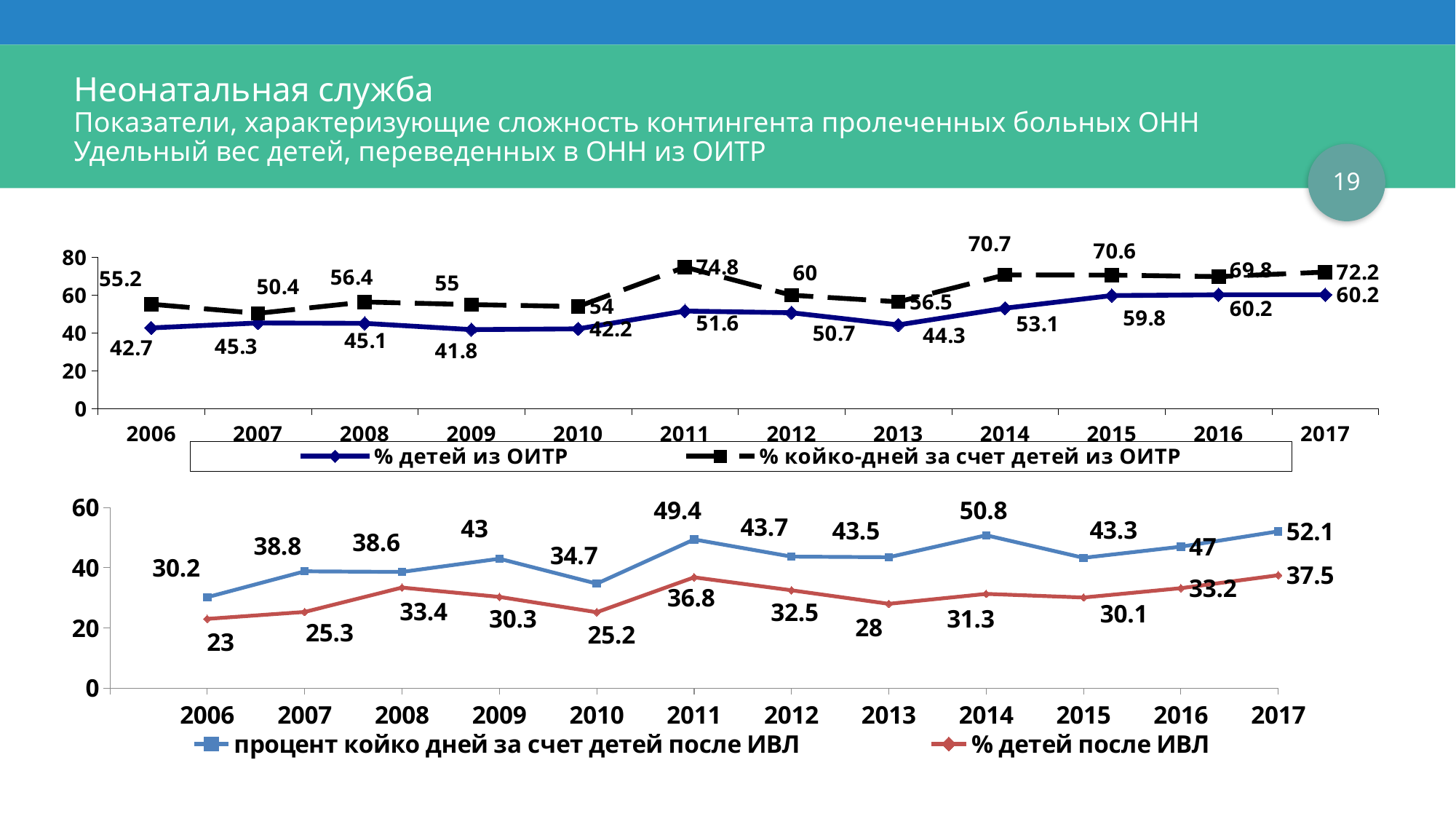
How many years are shown on the x axis of the bottom chart? 12 In the top chart, what is the value of "% детей из ОИТР" for 2011? 51.6 In the top chart, what is the value of "% койко-дней за счет детей из ОИТР" for 2014? 70.7 In the top chart, what is the difference between "% койко-дней за счет детей из ОИТР" and "% детей из ОИТР" in 2017? 12 In the bottom chart, in which year is "% детей после ИВЛ" lowest? 2006 What type of chart is the bottom chart? line chart In the bottom chart, which is larger in 2014: "процент койко дней за счет детей после ИВЛ" or "% детей после ИВЛ"? процент койко дней за счет детей после ИВЛ In the bottom chart, what is the value of "% детей после ИВЛ" for 2008? 33.4 In the top chart, how many series does the legend list? 2 In the top chart, in which year is "% койко-дней за счет детей из ОИТР" highest? 2011 In the bottom chart, what is the value of "процент койко дней за счет детей после ИВЛ" for 2017? 52.1 In the top chart, in which year is "% детей из ОИТР" lowest? 2009